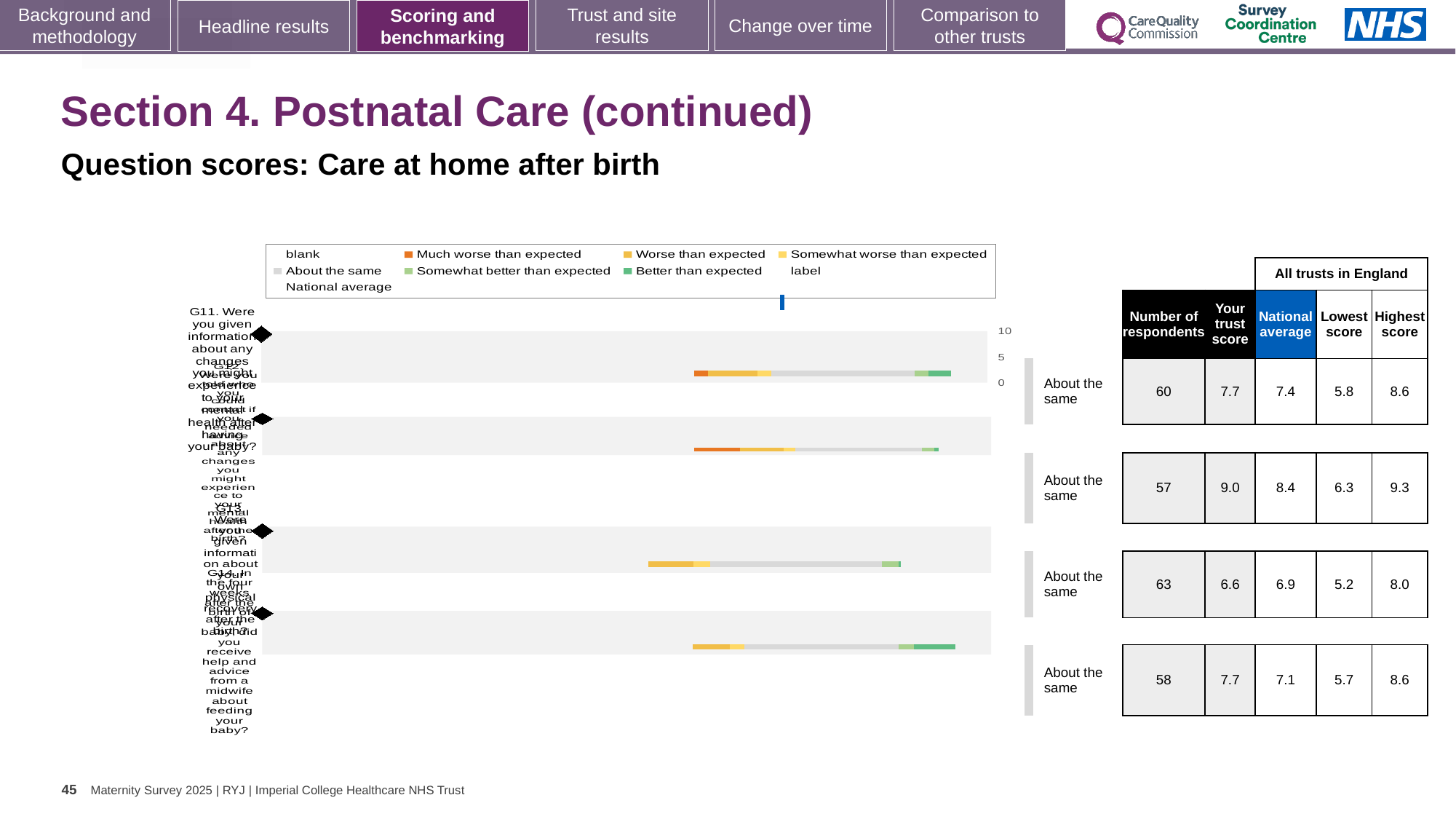
In the table beside the chart, what is the trust score for the second row? 9.0 In the table beside the chart, is the trust score in the third row larger or smaller than the national average? smaller In the table beside the chart, what is the difference between the trust score and the national average in the second row? 0.6 Which legend entry is shown in orange? Much worse than expected In the table beside the chart, what is the number of respondents for the first row? 60 In the table beside the chart, what is the national average for the third row? 6.9 In the table beside the chart, which row has the lowest trust score? the third row (6.6) What kind of chart is shown on the slide? bar chart How many stacked bars are plotted in the chart? 4 Which legend entry is shown in dark green? Better than expected In the table beside the chart, what is the highest score for the fourth row? 8.6 In the table beside the chart, which row has the highest trust score? the second row (9.0)